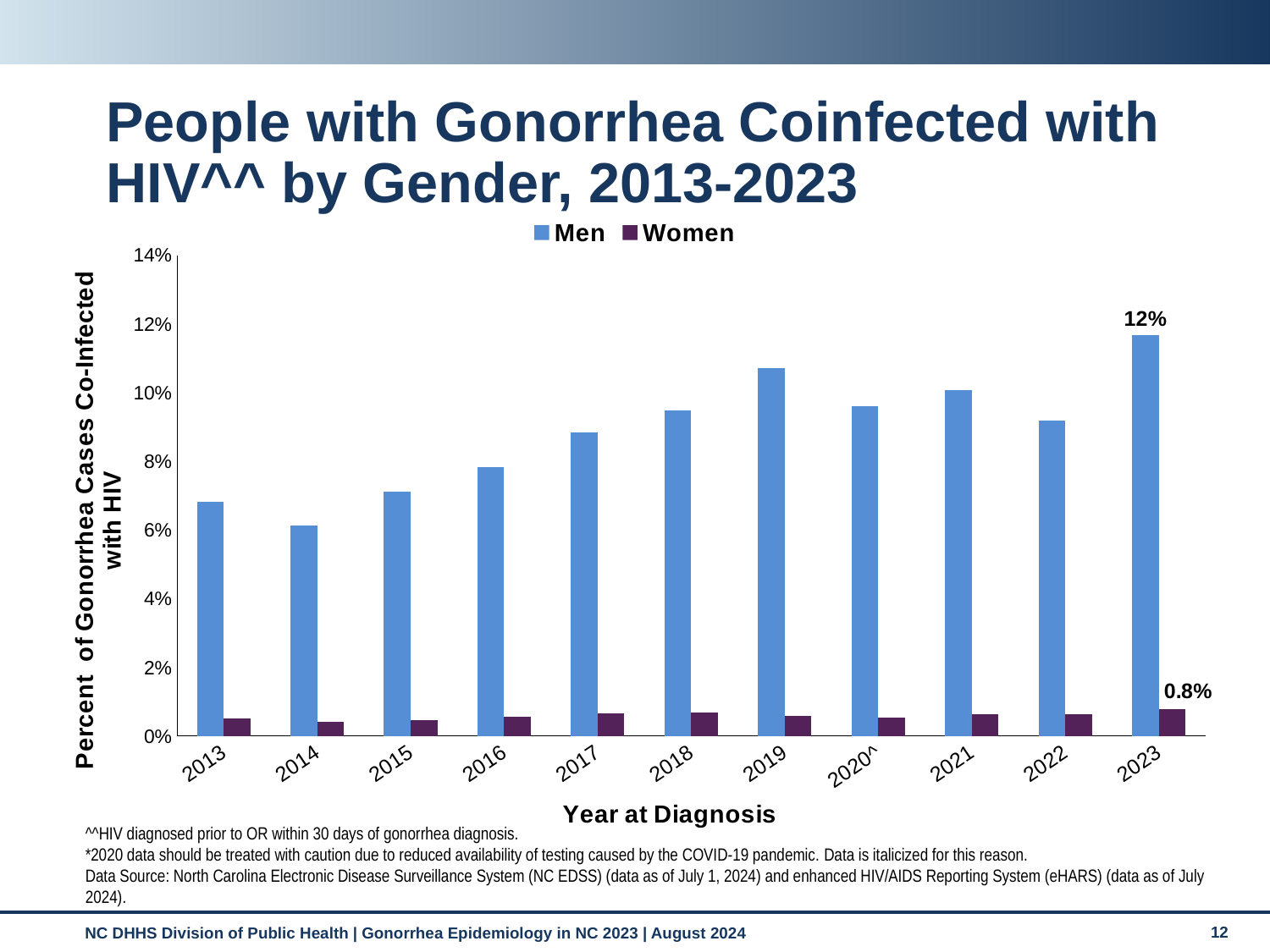
In which year is the Men series at its lowest? 2014 Is the value for Men in 2019 greater or less than 10%? greater Does the Men series generally rise or fall from 2013 to 2023? rise What is the percentage of men with gonorrhea co-infected with HIV in 2023? 12% What is the percentage of women with gonorrhea co-infected with HIV in 2023? 0.8% How many series does the legend list? 2 Is the value for Men in 2013 greater or less than 8%? less Which is larger for Men: the value in 2019 or the value in 2020^? 2019 What is the difference between the Men and Women values in 2023? 11.2% How many years are shown on the x axis? 11 What kind of chart is shown on the slide? bar chart In which year is the Men series at its highest? 2023